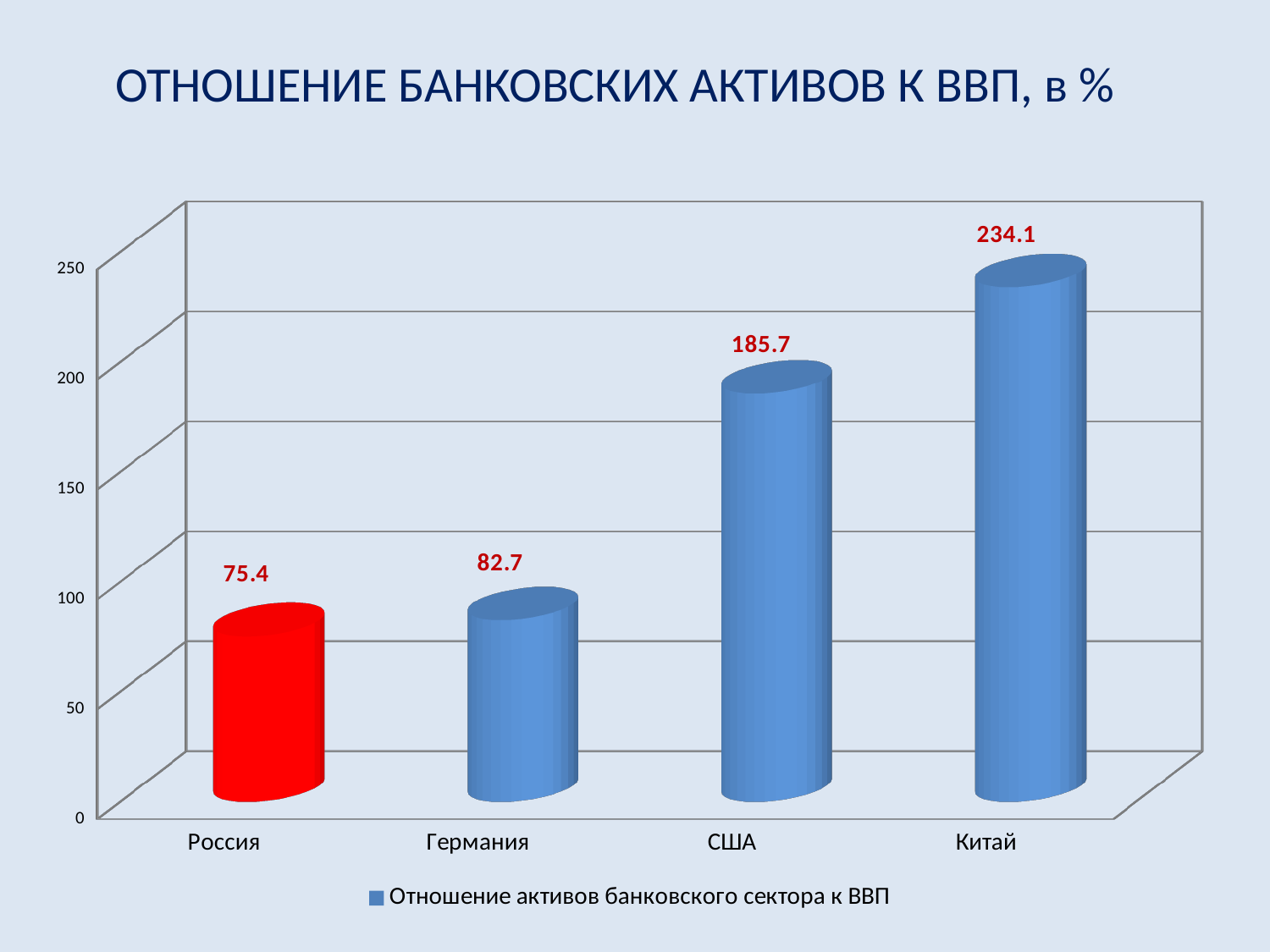
What is the value for США? 185.7 Which is larger, the value for США or the value for Германия? США What kind of chart is this? bar chart What is the value for Россия? 75.4 How many countries are shown on the chart? 4 What is the value for Китай? 234.1 Which country has the lowest value? Россия Which bar is coloured red? Россия What is the difference between the values for Германия and Россия? 7.3 Which country has the highest value? Китай What is the value for Германия? 82.7 What is the difference between the values for Китай and США? 48.4